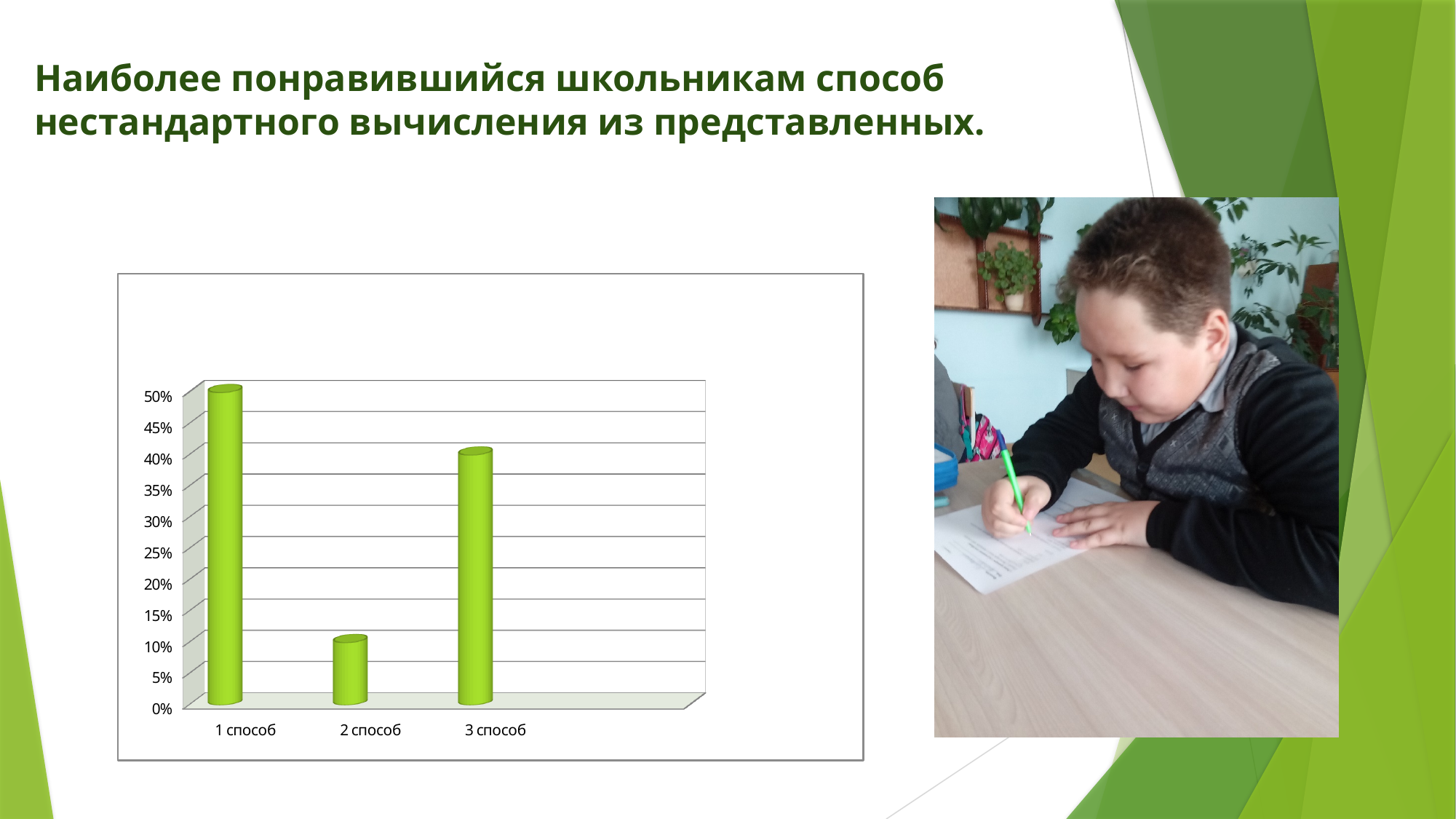
How many categories are shown on the x axis of the chart? 3 What is the value for 3 способ? 40% Is the value for 2 способ greater or less than 20%? less Is the value for 3 способ greater or less than 30%? greater Which is larger, the value for 3 способ or the value for 2 способ? 3 способ What is the value for 1 способ? 50% What is the highest value shown on the vertical axis of the chart? 50% Which category has the highest value in the chart? 1 способ What kind of chart is shown on the slide? bar chart What is the difference between the values for 1 способ and 3 способ? 10% What is the value for 2 способ? 10% Which category has the lowest value in the chart? 2 способ